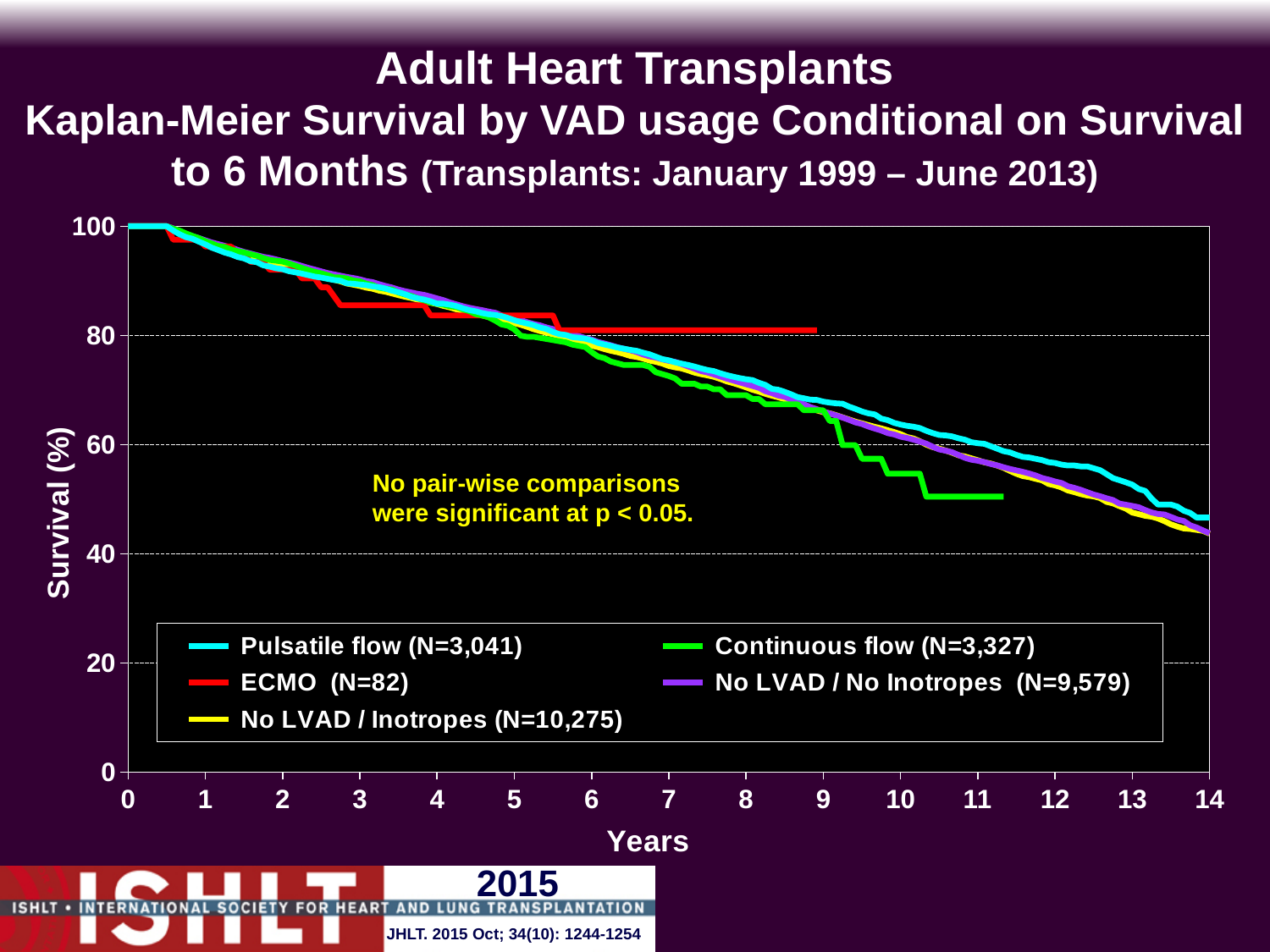
Is the survival value for Pulsatile flow at 14 years greater or less than 40? greater At 11 years, which has the higher survival: Pulsatile flow or Continuous flow? Pulsatile flow Do the survival curves rise or fall as the years increase? fall How many series does the legend list? 5 What is the sample size (N) for the ECMO group shown in the legend? 82 What is the sample size (N) for the No LVAD / Inotropes group shown in the legend? 10,275 Is the survival value for Continuous flow at 9 years greater or less than 60? greater At 8 years, which has the higher survival: ECMO or Continuous flow? ECMO Which series has the lowest survival at 11 years? Continuous flow What kind of chart is shown on the slide? line chart Is the survival value for Continuous flow at 11 years greater or less than 60? less